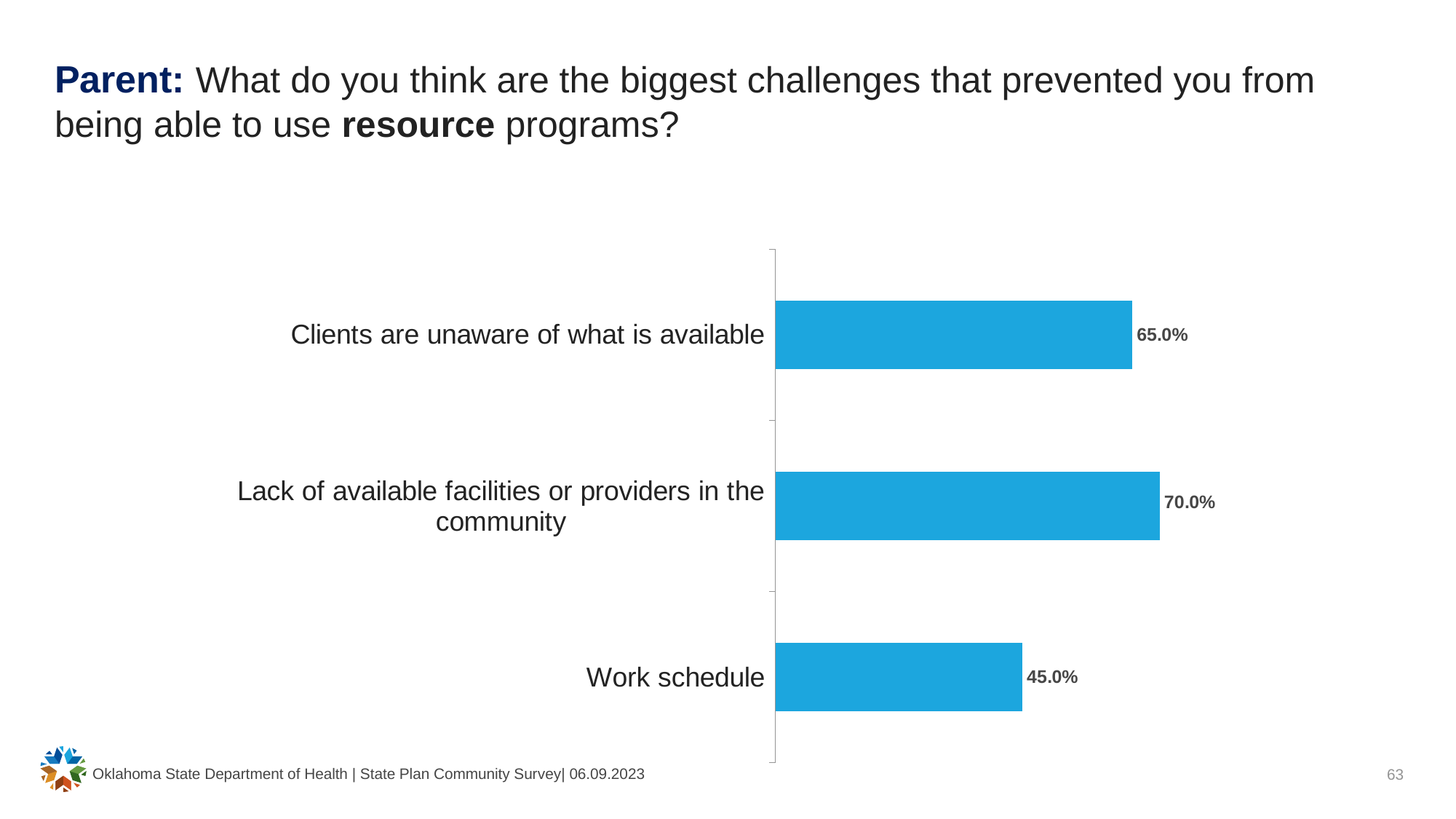
What is the difference between the values for "Lack of available facilities or providers in the community" and "Clients are unaware of what is available"? 5.0% Are the bars in the chart horizontal or vertical? Horizontal What is the difference between the values for "Lack of available facilities or providers in the community" and "Work schedule"? 25.0% What kind of chart is shown on the slide? Bar chart How many categories are shown in the chart? 3 Which category has the highest value? Lack of available facilities or providers in the community What is the value for "Work schedule"? 45.0% Which category has the lowest value? Work schedule What is the value for "Lack of available facilities or providers in the community"? 70.0% What colour are the bars in the chart? Blue What is the value for "Clients are unaware of what is available"? 65.0% Which is larger: the value for "Clients are unaware of what is available" or the value for "Work schedule"? Clients are unaware of what is available